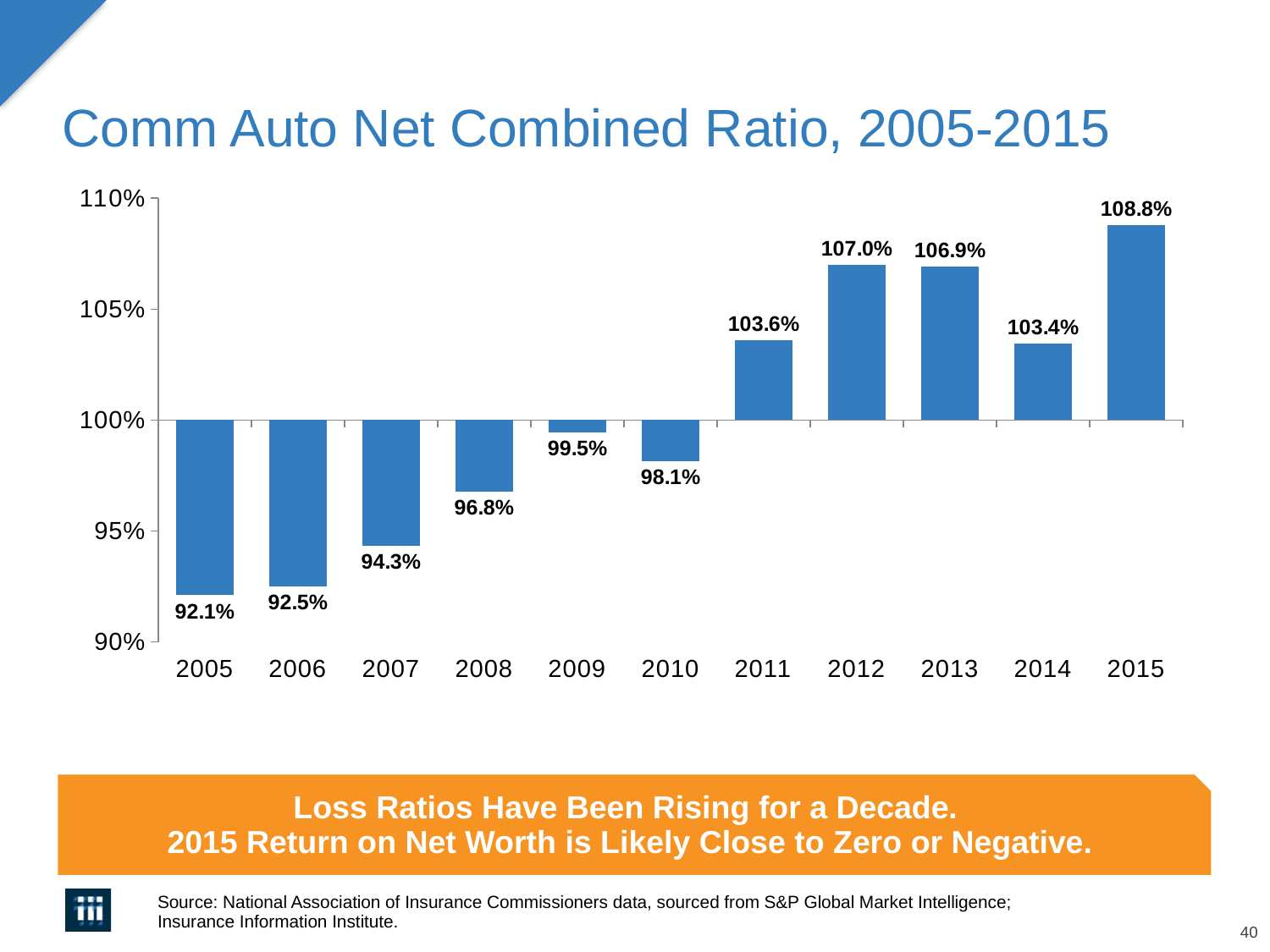
What is the title of the chart? Comm Auto Net Combined Ratio, 2005-2015 Which year has a higher combined ratio, 2008 or 2013? 2013 What is the combined ratio for 2005? 92.1% What is the difference between the combined ratios for 2015 and 2014? 5.4% What is the difference between the combined ratios for 2011 and 2010? 5.5% Which year has the lowest combined ratio? 2005 How many years are shown on the chart? 11 Is the value for 2012 greater or less than 105%? greater What is the combined ratio for 2015? 108.8% What is the combined ratio for 2009? 99.5% What kind of chart is shown on the slide? Bar chart Which year has the highest combined ratio? 2015